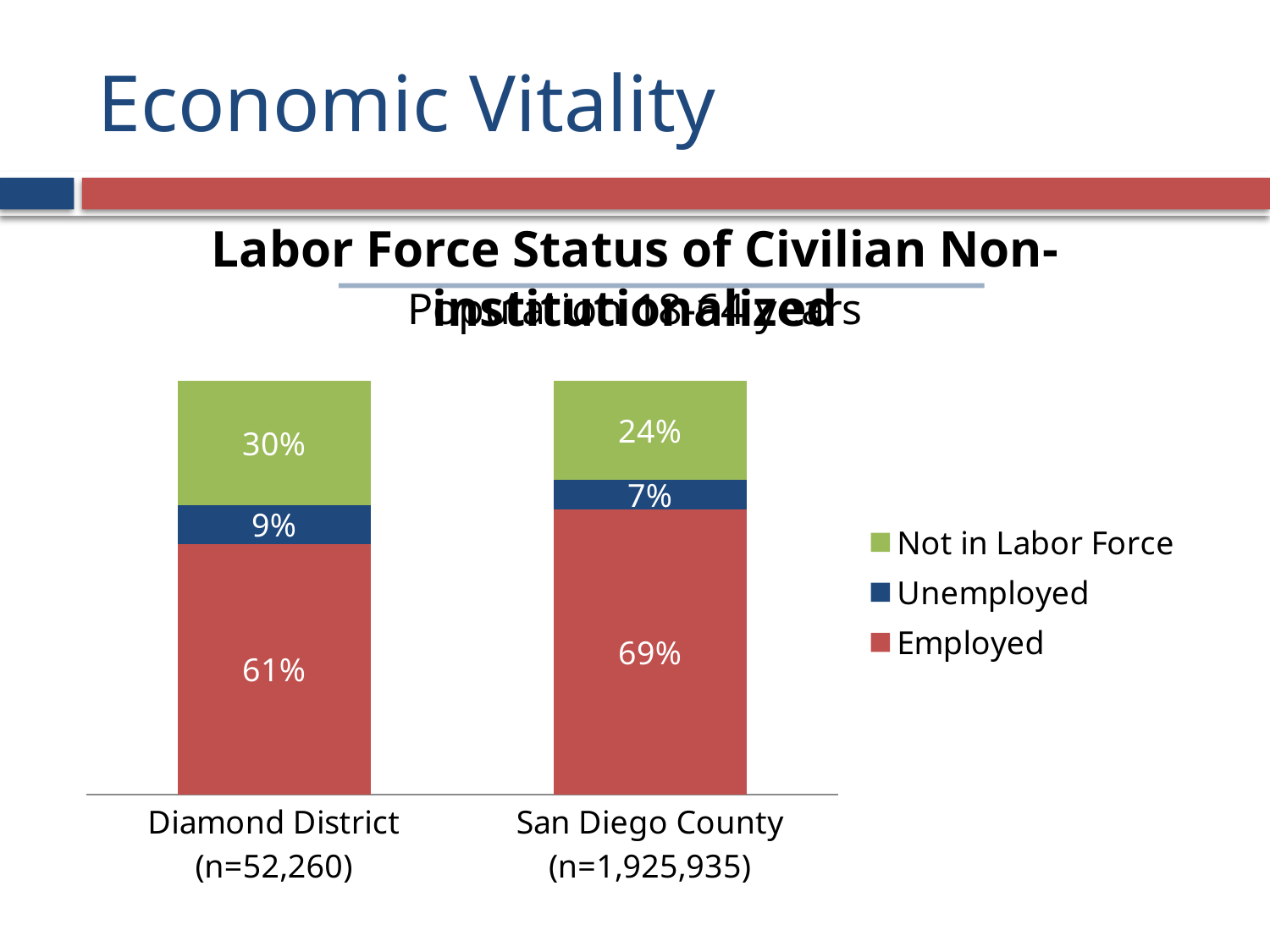
What is the Unemployed percentage for the Diamond District? 9% How many series does the legend list? 3 What kind of chart is shown on the slide? Stacked bar chart What percentage of the San Diego County population is Employed? 69% Which area has the higher Not in Labor Force percentage? Diamond District What is the difference in the Employed percentage between San Diego County and the Diamond District? 8% Which colour represents the Employed series in the legend? Red What percentage of the Diamond District population is Employed? 61% What is the Not in Labor Force percentage for San Diego County? 24% Which area has the higher Employed percentage, Diamond District or San Diego County? San Diego County How many categories (areas) are shown on the x axis? 2 What is the difference in the Unemployed percentage between the Diamond District and San Diego County? 2%